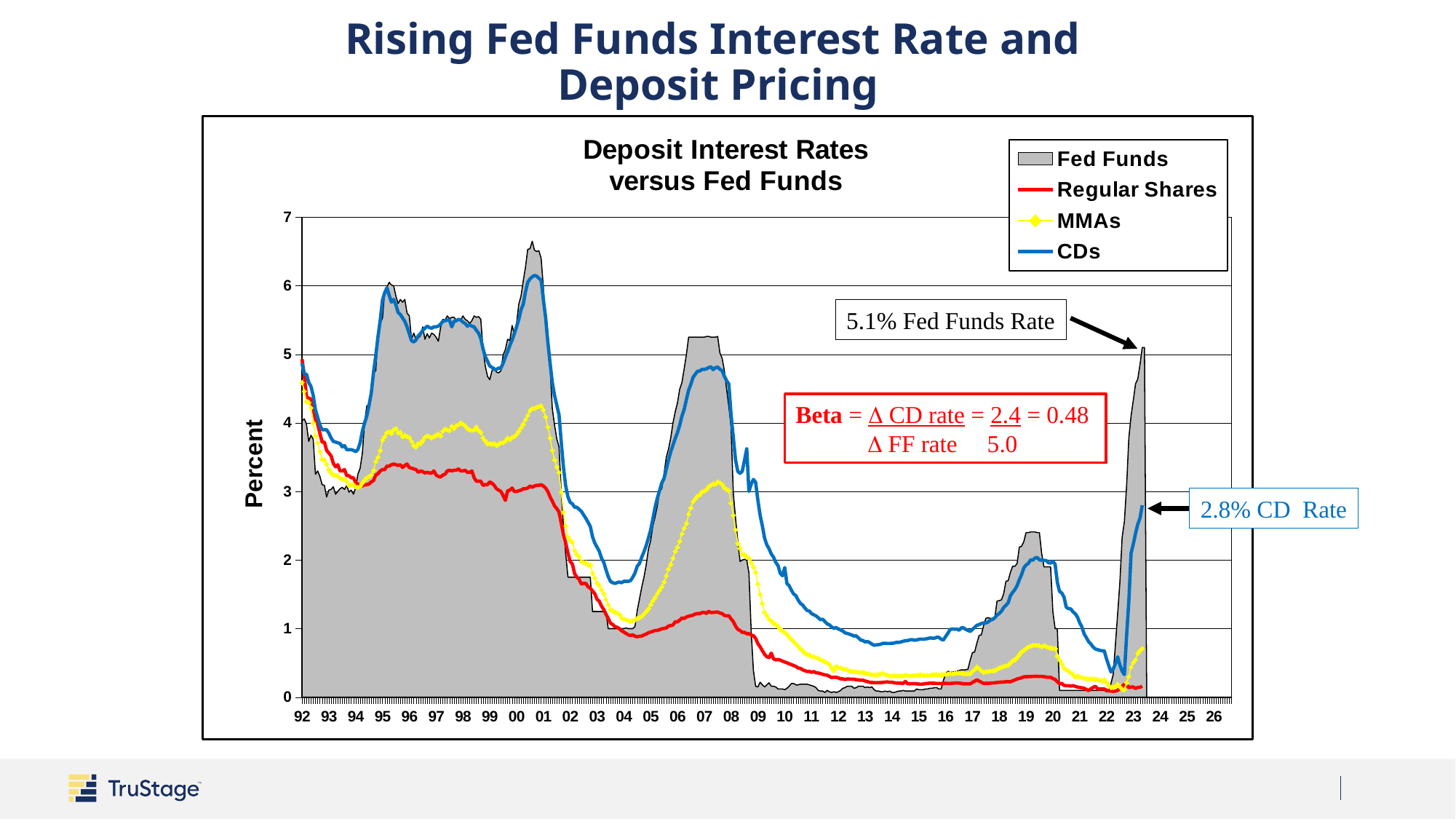
What kind of chart is shown on the slide? combination area and line chart What Fed Funds rate is called out by the annotation at the right end of the chart? 5.1% How many series does the legend list? 4 Is the peak of the Fed Funds series around 2000-01 greater or less than 6? greater What is the difference between the annotated 5.1% Fed Funds rate and the annotated 2.8% CD rate? 2.3% Does the Regular Shares series rise or fall overall from 1992 to 2023? fall What CD rate is called out by the annotation at the right end of the chart? 2.8% Is the CDs value in 2014 greater or less than 1? less What is the title of the chart? Deposit Interest Rates versus Fed Funds What is the label on the vertical axis? Percent In 2007, which is higher: CDs or Regular Shares? CDs Which series is the highest at the right end of the chart in 2023? Fed Funds